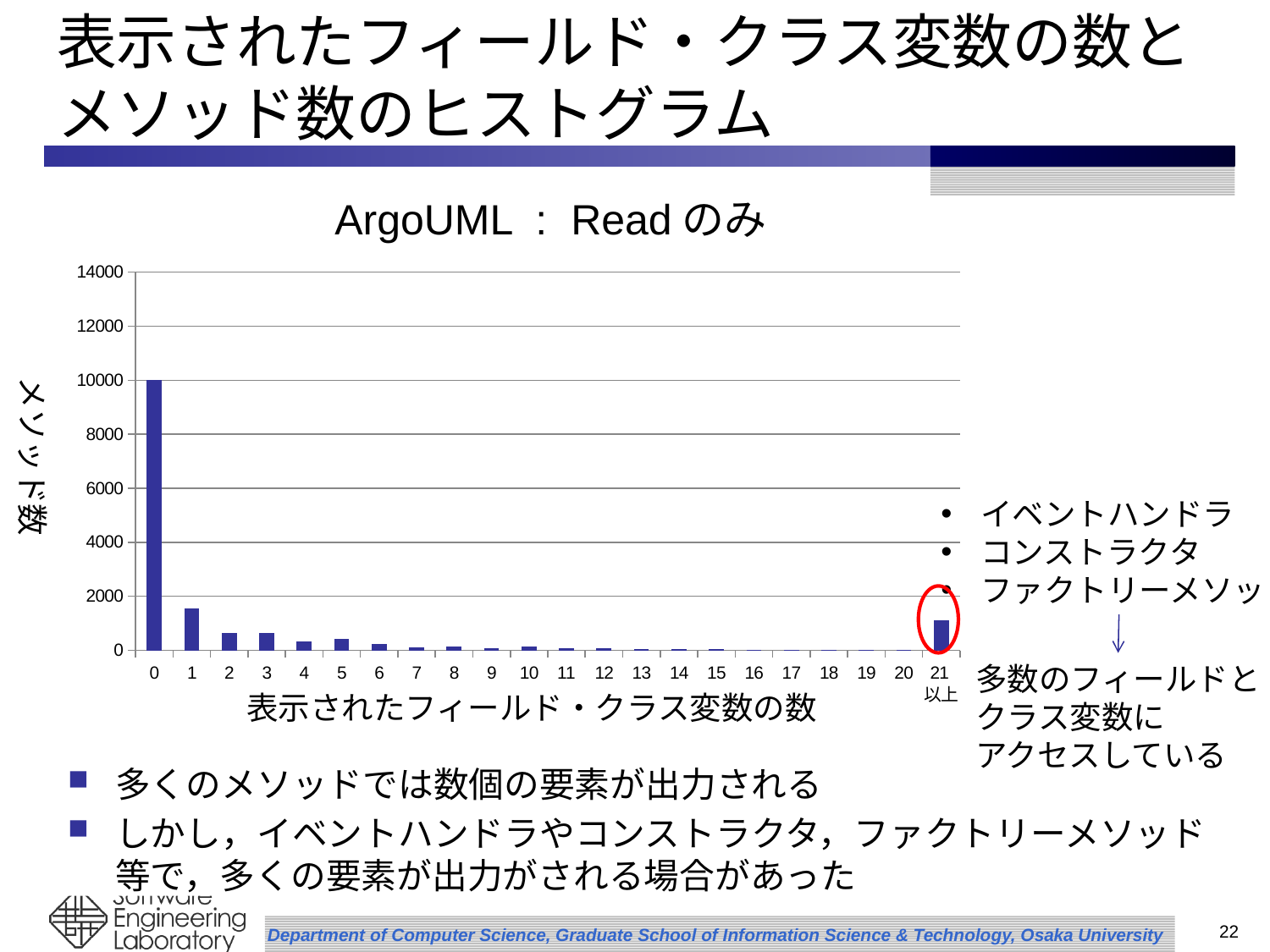
How many categories are shown on the x axis of the chart? 22 Is the value for category 21以上 greater or less than 2000? less What is the title of the chart? ArgoUML : Read のみ Do the values generally rise or fall as the x axis goes from 0 to 20? fall Which category has the highest number of methods (メソッド数)? 0 What kind of chart is shown on the slide? bar chart Which is larger, the value for category 0 or the value for category 1? 0 Which is larger, the value for category 1 or the value for category 21以上? 1 What is the label of the x axis of the chart? 表示されたフィールド・クラス変数の数 Which is larger, the value for category 1 or the value for category 2? 1 Is the value for category 1 greater or less than 2000? less Is the value for category 0 greater or less than 8000? greater